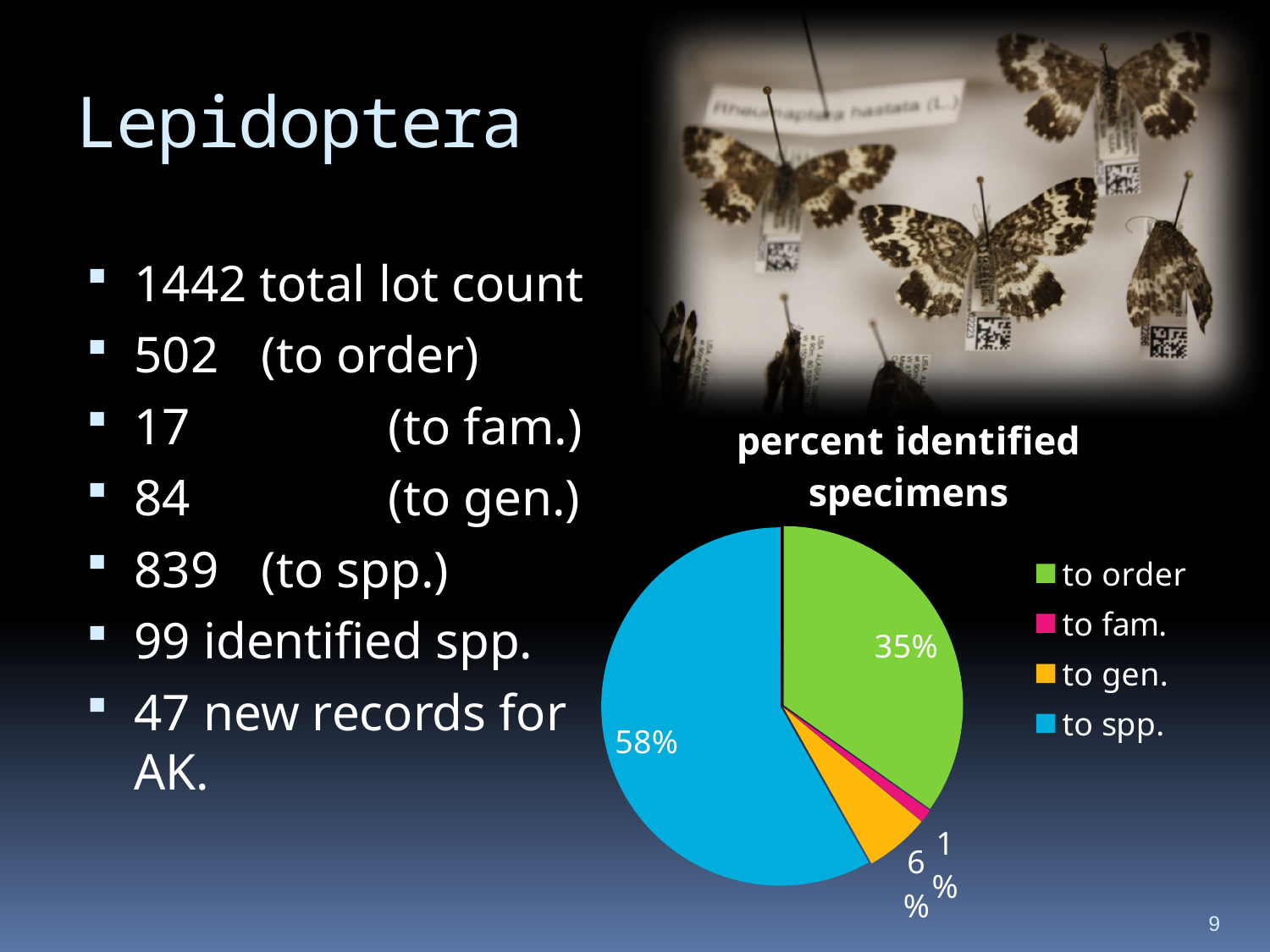
How many entries does the chart legend list? 4 What kind of chart is shown on the slide? pie chart Which is larger, the share for "to gen." or the share for "to fam."? to gen. What is the title of the chart? percent identified specimens What percentage of identified specimens is labelled for "to fam."? 1% What percentage of identified specimens is labelled for "to gen."? 6% Which category has the smallest share of the pie? to fam. What percentage of identified specimens is labelled for "to order"? 35% Which category has the largest share of the pie? to spp. What is the difference in percentage points between "to spp." and "to order"? 23 How many slices does the pie chart have? 4 What percentage of identified specimens is labelled for "to spp."? 58%